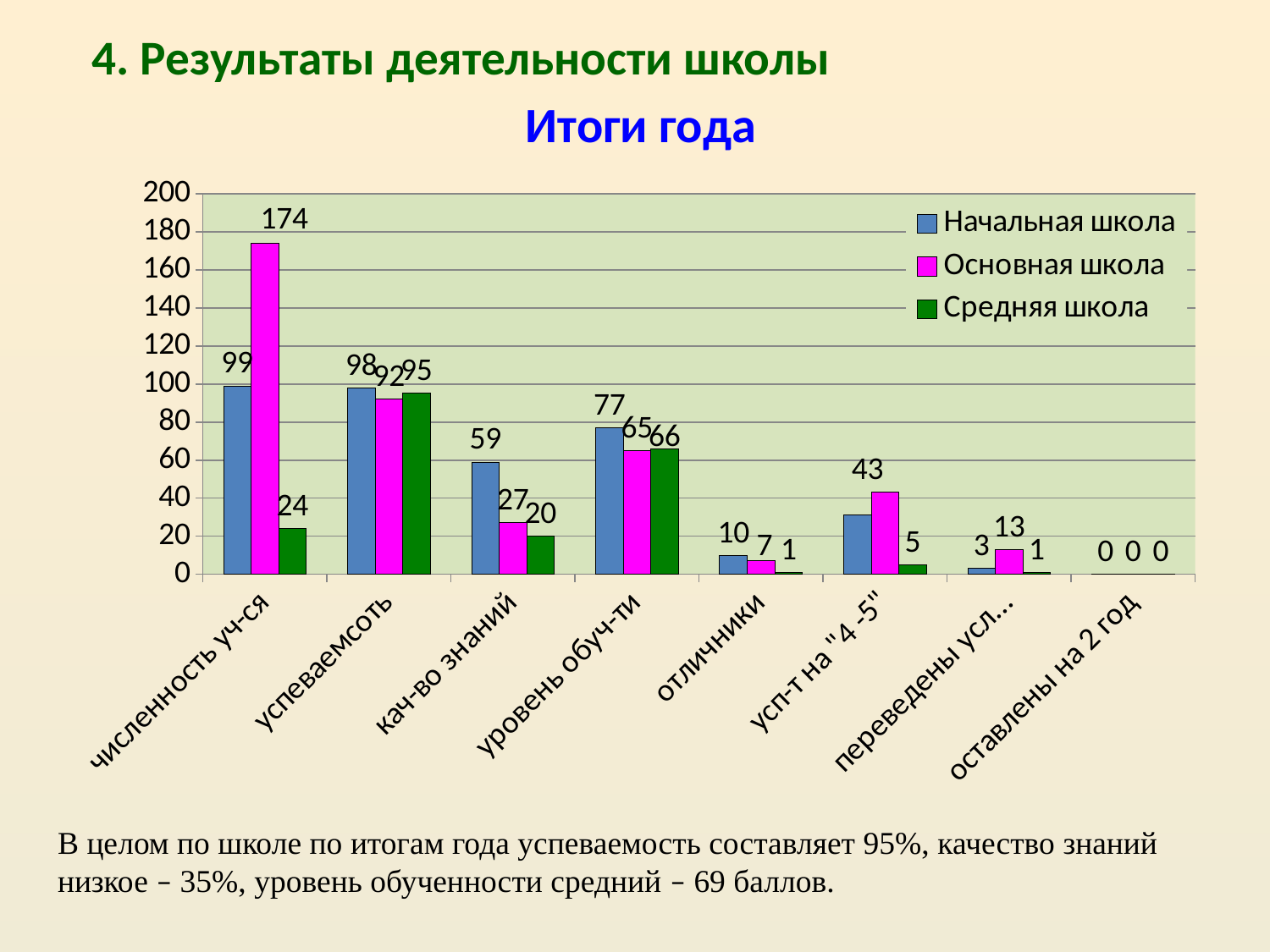
How many series does the legend list? 3 What is the value for Средняя школа in the кач-во знаний category? 20 What is the difference between the Начальная школа and Основная школа values in the кач-во знаний category? 32 What is the title of the chart? Итоги года Which series has the lowest value in the отличники category? Средняя школа Which is larger: the Основная школа value or the Средняя школа value in the успеваемсоть category? Средняя школа What is the value for Основная школа in the численность уч-ся category? 174 How many categories are shown on the x axis? 8 What is the value for Начальная школа in the уровень обуч-ти category? 77 What kind of chart is shown on the slide? bar chart Is the value for Начальная школа in the усп-т на "4-5" category greater or less than 20? greater Which series has the highest value in the численность уч-ся category? Основная школа